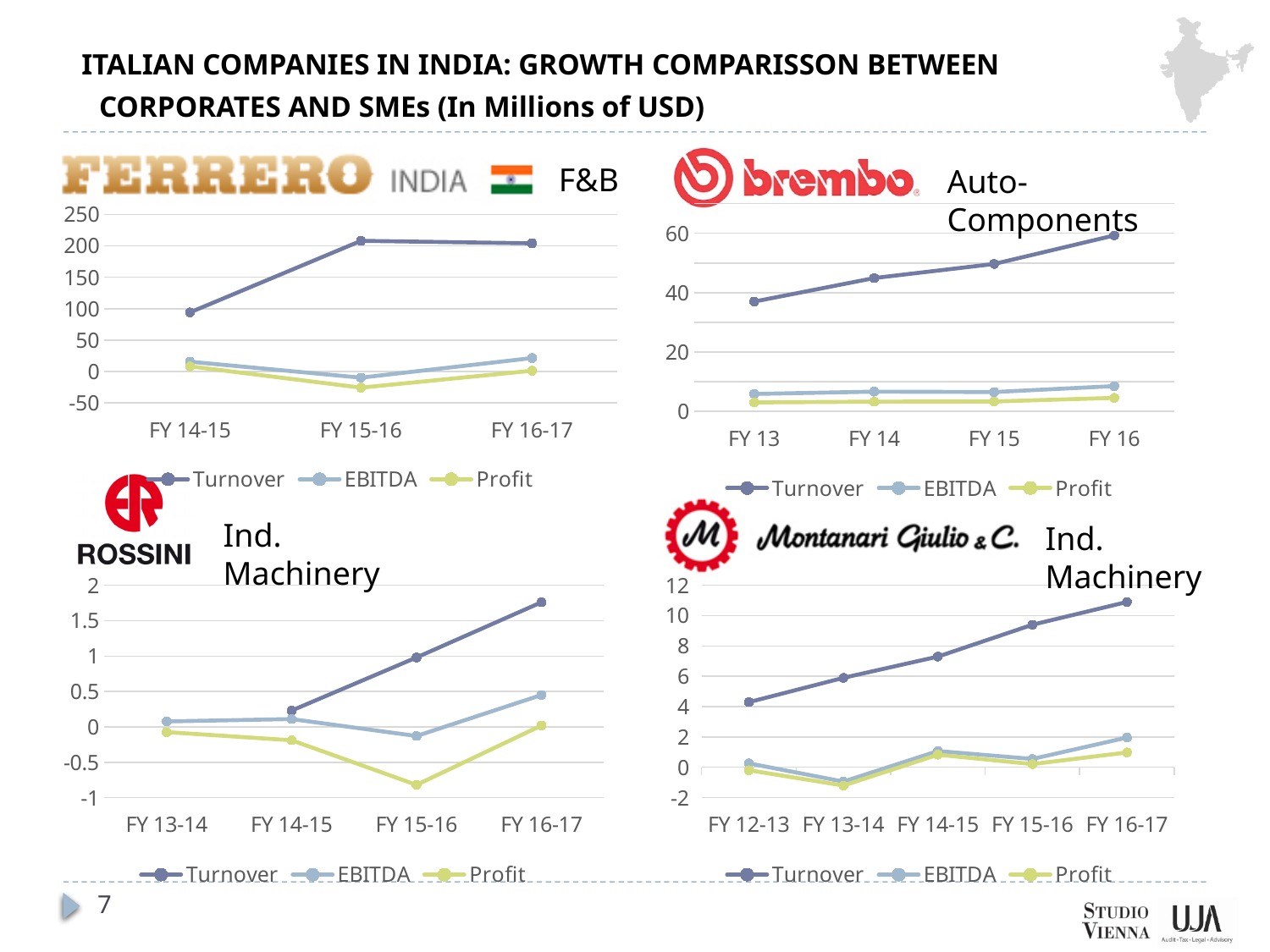
How many fiscal years are plotted on the x axis of the Montanari Giulio & C. chart? 5 In the Ferrero India chart, is the Turnover for FY 15-16 greater or less than 150? greater In the Ferrero India chart, is the Profit for FY 15-16 greater or less than 0? less How many series does the legend of the Brembo chart list? 3 In the Rossini chart, which fiscal year has the lowest Profit? FY 15-16 What kind of chart is the Ferrero India chart? Line chart In the Ferrero India chart, which fiscal year has the lowest Turnover? FY 14-15 In the Rossini chart, is the Turnover for FY 16-17 greater or less than 1.5? greater In the Brembo chart, does Turnover rise or fall from FY 13 to FY 16? Rise In the Montanari Giulio & C. chart, does Turnover rise or fall from FY 12-13 to FY 16-17? Rise How many fiscal years are plotted on the x axis of the Ferrero India chart? 3 In the Brembo chart, which fiscal year has the highest Turnover? FY 16